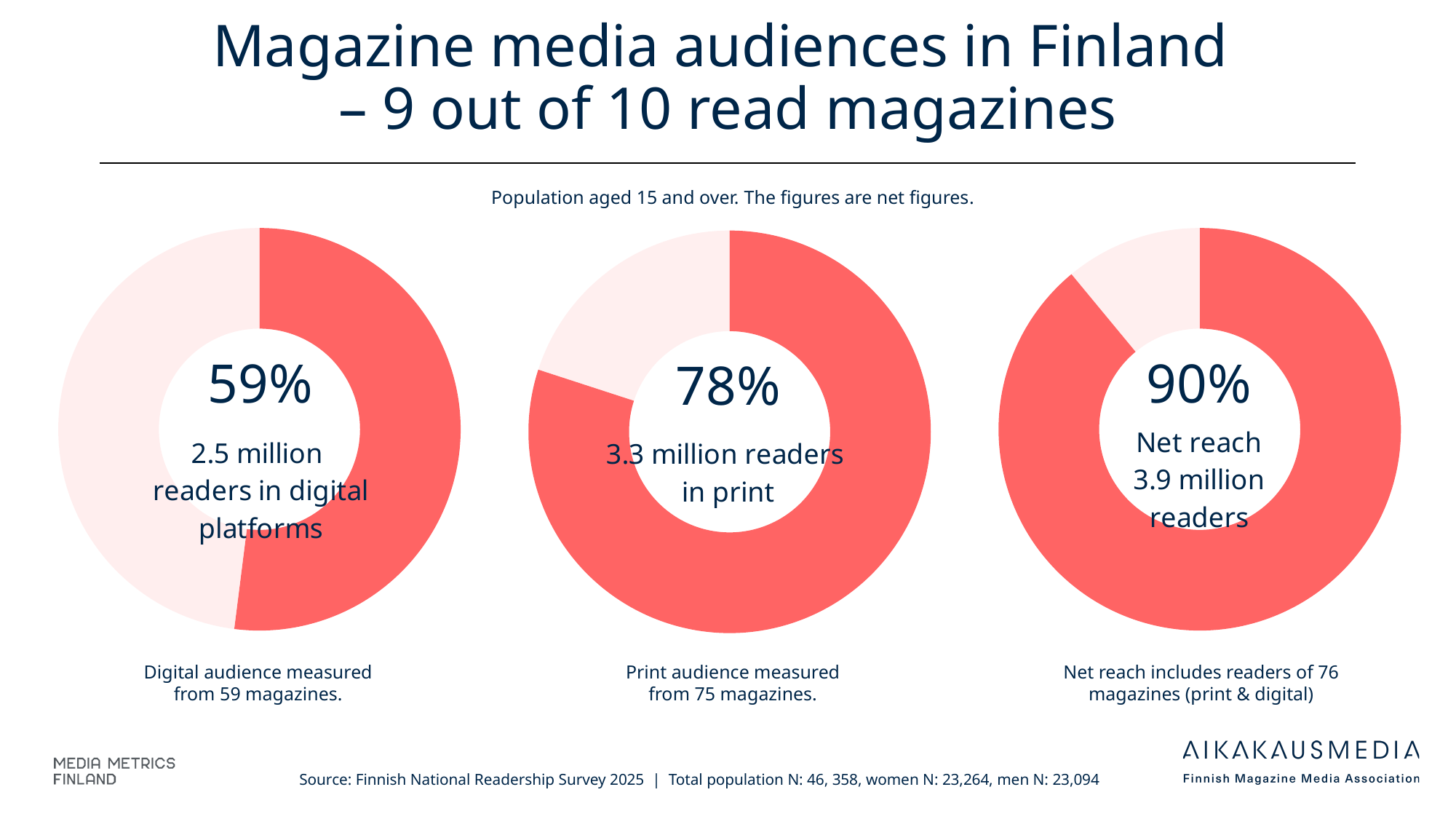
What percentage is shown in the centre of the middle donut chart (print)? 78% How many readers in print does the middle donut chart report? 3.3 million Which of the three donut charts shows the highest percentage? Net reach (90%) Which of the three donut charts shows the lowest percentage? Digital platforms (59%) How many readers in digital platforms does the left donut chart report? 2.5 million What percentage is shown in the centre of the right donut chart (net reach)? 90% What is the difference in percentage points between the print chart and the digital platforms chart? 19 percentage points What kind of chart is used to show the audience figures on this slide? Donut (pie) chart Is the percentage in the print donut chart larger or smaller than the percentage in the digital platforms donut chart? larger What percentage is shown in the centre of the left donut chart (digital platforms)? 59% How many readers does the net reach donut chart on the right report? 3.9 million How many donut charts are shown on the slide? 3